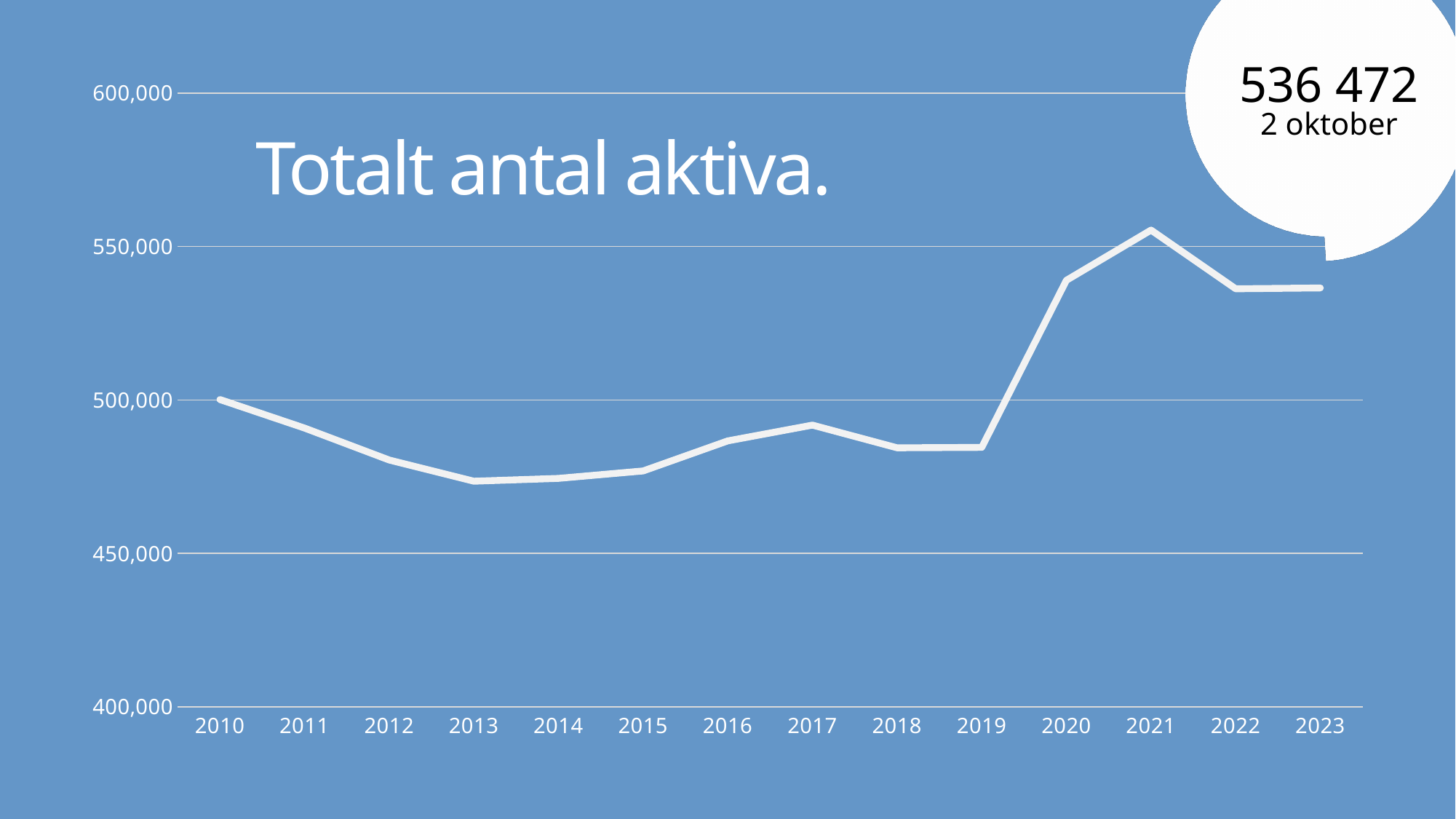
Is the value for 2013 greater or less than 500,000? less Is the value for 2021 greater or less than 550,000? greater What value does the callout give for 2 oktober? 536 472 Do the values rise or fall from 2010 to 2013? fall Is the value for 2020 greater or less than 500,000? greater Which year has the larger value, 2017 or 2018? 2017 What kind of chart is shown on the slide? line chart What is the title of the chart? Totalt antal aktiva. How many years are plotted along the x axis? 14 Which year has the highest value? 2021 Which year has the lowest value? 2013